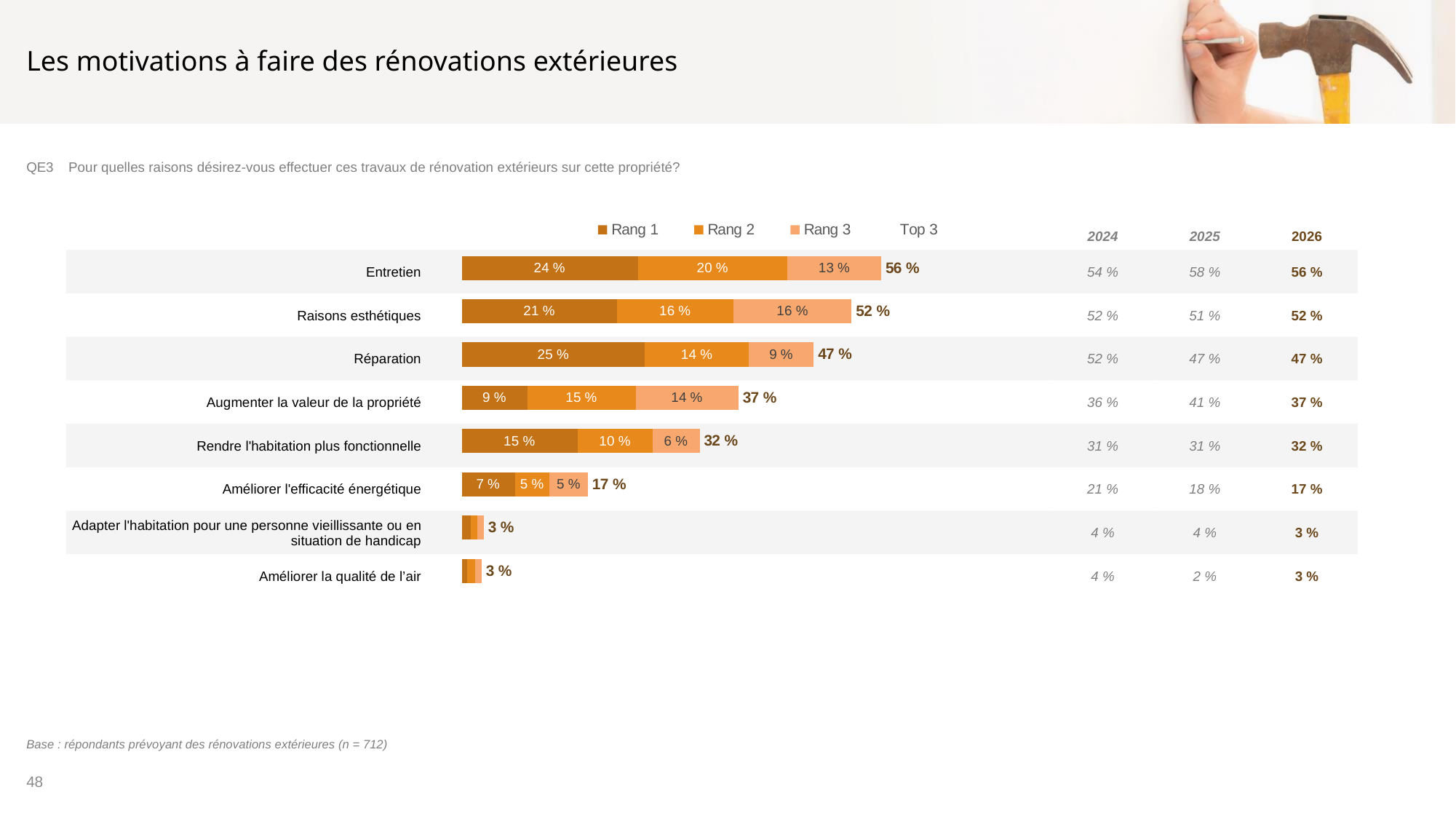
How many motivation categories are plotted in the chart? 8 Which is larger, the Rang 2 value for Entretien or the Rang 2 value for Réparation? Entretien What is the total of the stacked bar for Améliorer l'efficacité énergétique, as shown by its Top 3 label? 17 % What is the Top 3 value for Augmenter la valeur de la propriété? 37 % What kind of chart is shown on the slide? Stacked bar chart In the table on the right, what is the 2025 value for Réparation? 47 % How many 'Rang' series does the legend list? 3 Which category has the highest Rang 1 value? Réparation What is the difference between the Top 3 values for Entretien and Raisons esthétiques? 4 percentage points What is the Rang 1 value for Entretien? 24 % Which category has the highest Top 3 value? Entretien What is the Rang 3 value for Raisons esthétiques? 16 %